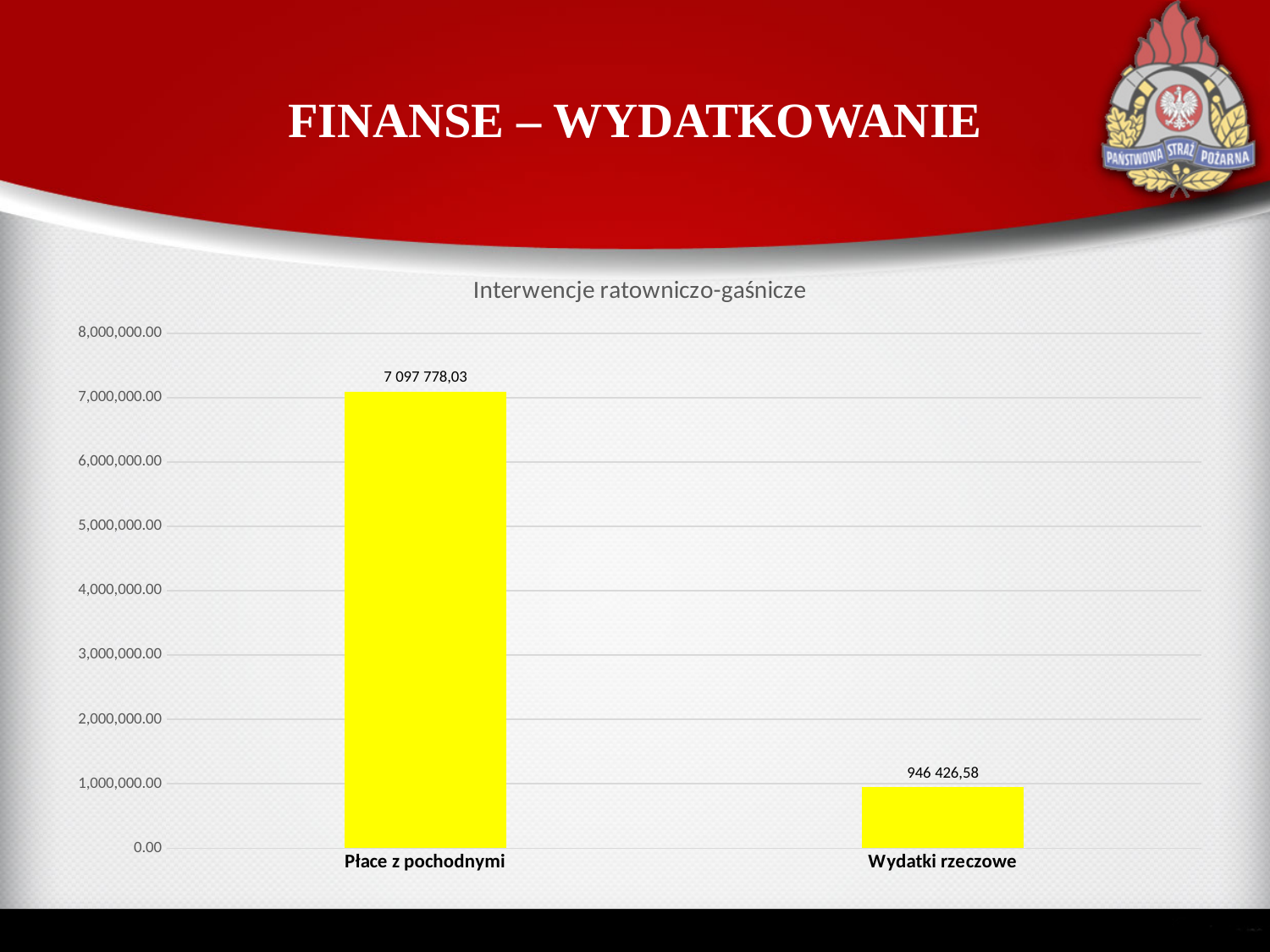
What colour are the bars in the chart? yellow What is the title of the chart? Interwencje ratowniczo-gaśnicze Which category has the highest value? Płace z pochodnymi How many categories are shown in the chart? 2 Which category has the lowest value? Wydatki rzeczowe What kind of chart is shown on the slide? bar chart What is the difference between the values for Płace z pochodnymi and Wydatki rzeczowe? 6 151 351,45 Which is larger, the value for Płace z pochodnymi or the value for Wydatki rzeczowe? Płace z pochodnymi Is the value for Płace z pochodnymi greater or less than 7,000,000.00? greater What is the value for Wydatki rzeczowe? 946 426,58 What is the value for Płace z pochodnymi? 7 097 778,03 Is the value for Wydatki rzeczowe greater or less than 1,000,000.00? less